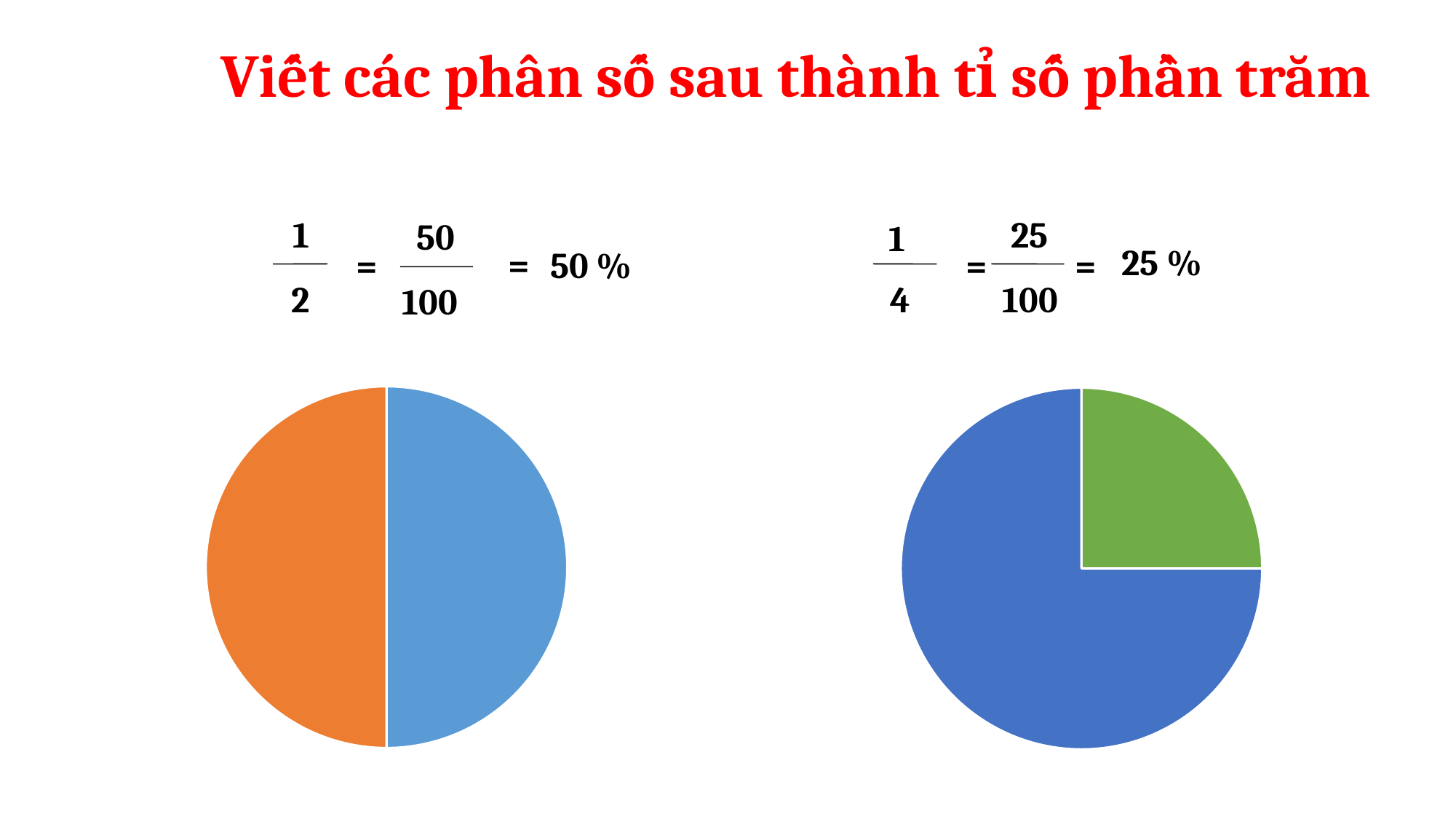
What share of the left pie chart does the orange slice represent, according to the percentage printed above it? 50 % What kind of chart is the pie on the left side of the slide? pie chart What is the title text at the top of the slide? Viết các phân số sau thành tỉ số phần trăm What share of the right pie chart does the green slice represent, according to the percentage printed above it? 25 % In the right pie chart, which slice is the smallest? the green slice How many slices does the left pie chart have? 2 In the right pie chart, which is larger, the blue slice or the green slice? the blue slice What two colours are used for the slices of the left pie chart? orange and blue In the right pie chart, which slice is the largest? the blue slice How many slices does the right pie chart have? 2 What kind of chart is the chart on the right side of the slide? pie chart